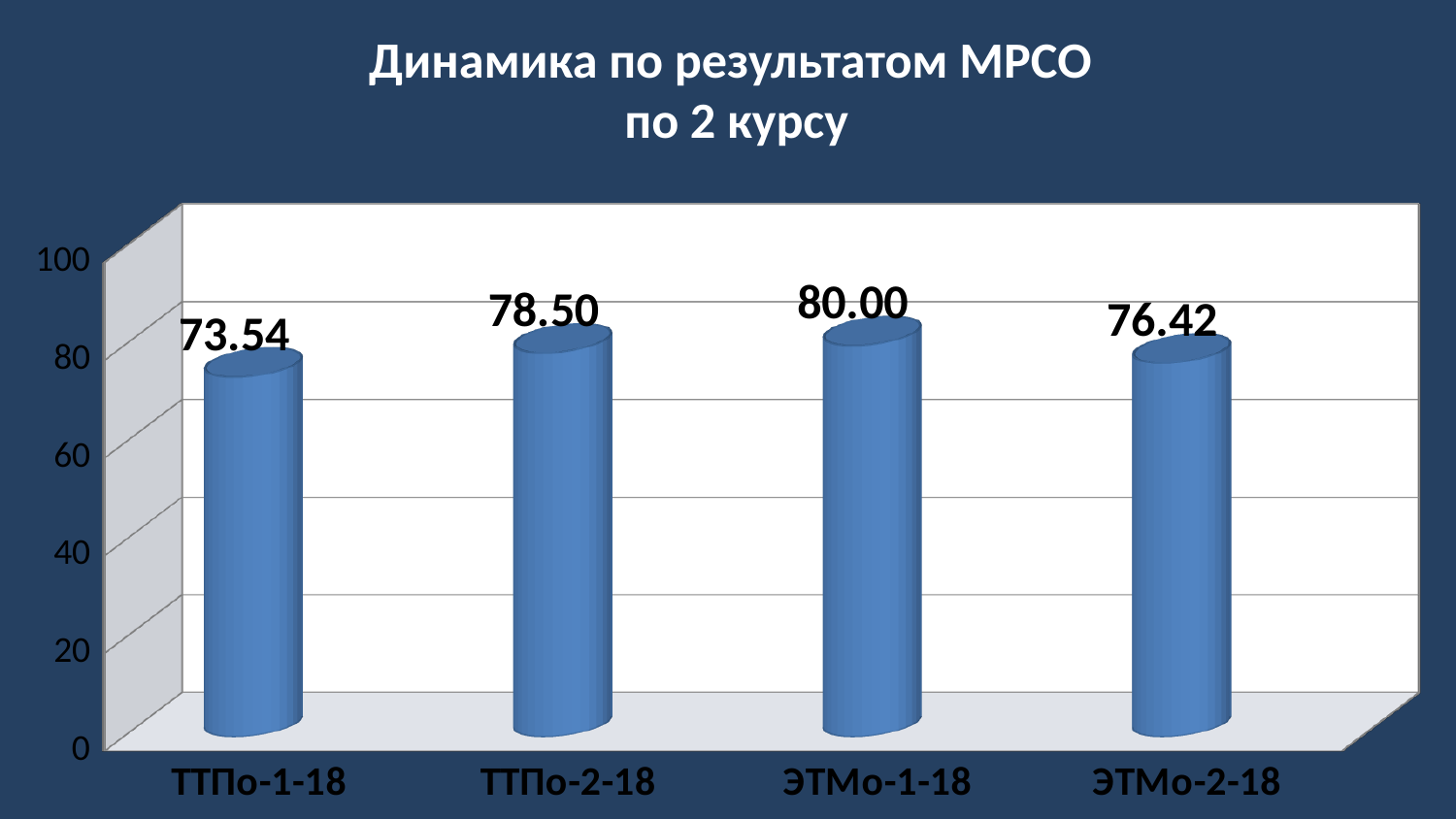
What is the title of the chart? Динамика по результатом МРСО по 2 курсу Which group has the lowest value? ТТПо-1-18 Is the value for ТТПо-1-18 greater or less than 80? less Which is larger, the value for ТТПо-2-18 or ЭТМо-2-18? ТТПо-2-18 What is the value for ЭТМо-1-18? 80.00 What is the value for ЭТМо-2-18? 76.42 How many groups are shown on the chart? 4 What is the difference between the values for ЭТМо-1-18 and ТТПо-1-18? 6.46 Which group has the highest value? ЭТМо-1-18 What is the difference between the values for ТТПо-2-18 and ЭТМо-2-18? 2.08 What is the value for ТТПо-1-18? 73.54 What kind of chart is shown on the slide? bar chart